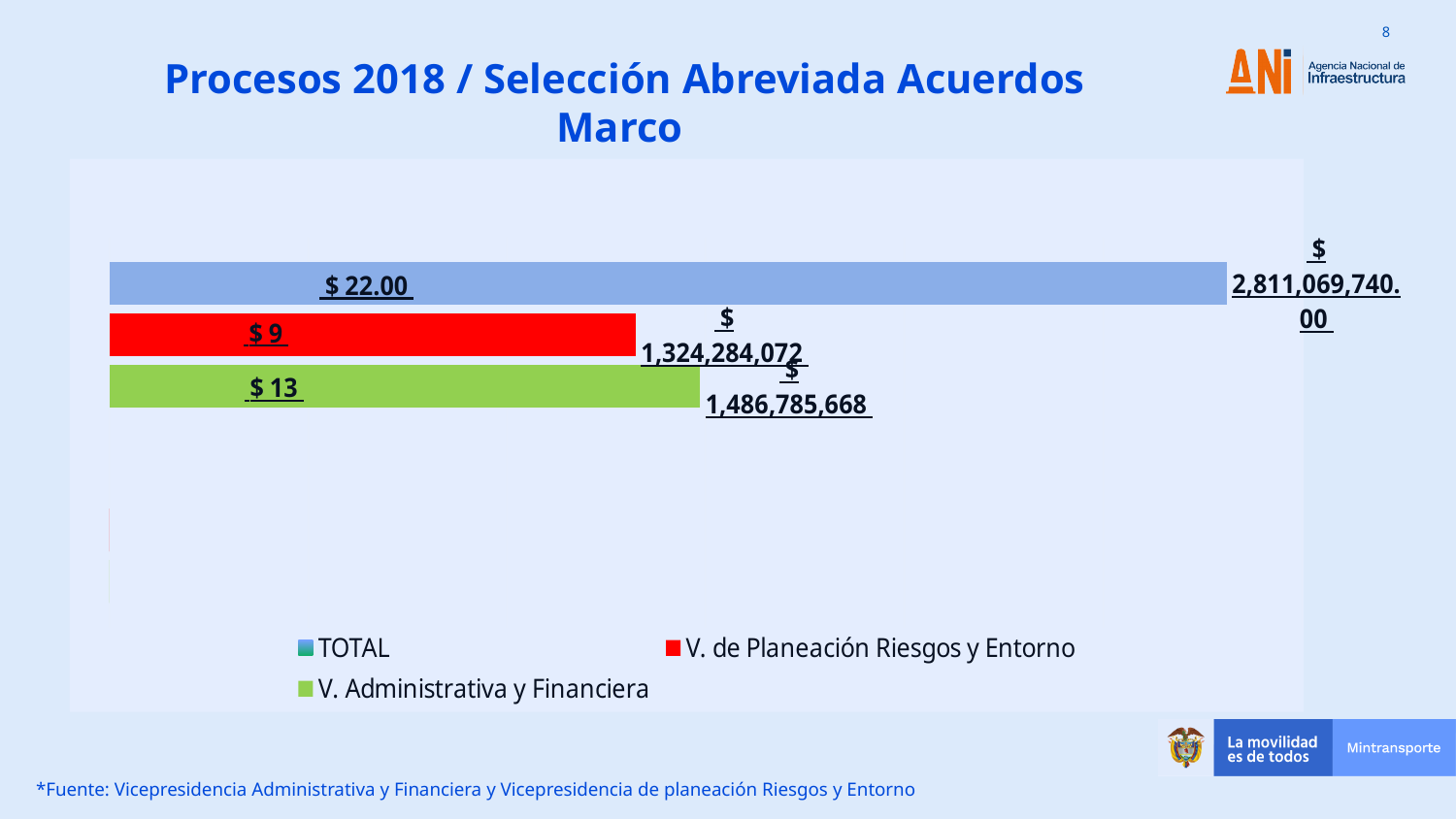
What label is printed inside the TOTAL bar? $ 22.00 Which series has the shortest bar? V. de Planeación Riesgos y Entorno Which is larger, the amount for V. Administrativa y Financiera or the amount for V. de Planeación Riesgos y Entorno? V. Administrativa y Financiera What is the amount shown at the end of the V. Administrativa y Financiera bar? $ 1,486,785,668 What label is printed inside the V. de Planeación Riesgos y Entorno bar? $ 9 What kind of chart is shown on the slide? bar chart Which series has the longest bar? TOTAL What is the amount shown at the end of the V. de Planeación Riesgos y Entorno bar? $ 1,324,284,072 How many series does the legend list? 3 What colour is the TOTAL bar? blue What is the amount shown at the end of the TOTAL bar? $ 2,811,069,740.00 What label is printed inside the V. Administrativa y Financiera bar? $ 13